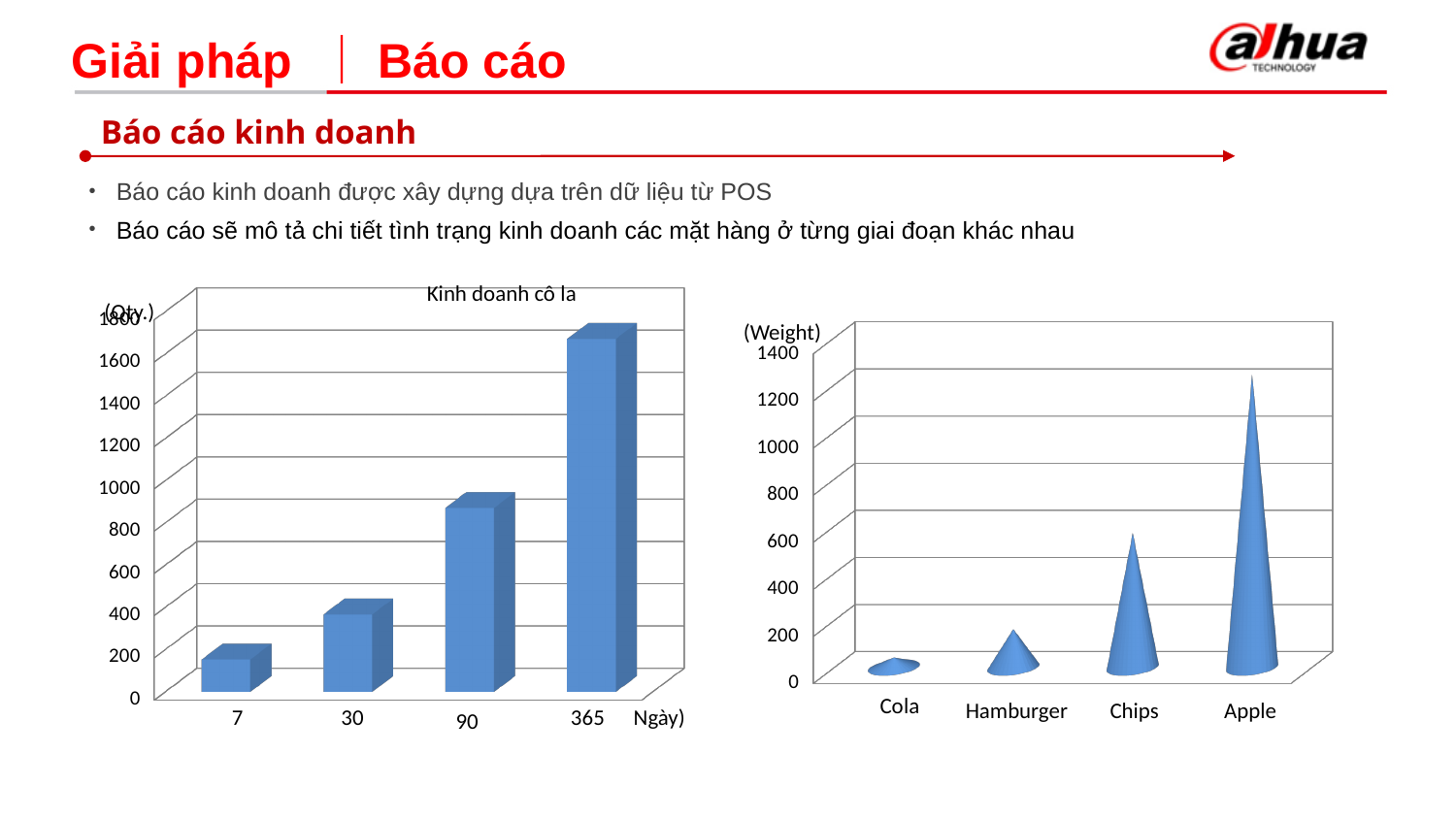
In the left chart "Kinh doanh cô la", is the value for 90 greater or less than 1000? less In the left chart "Kinh doanh cô la", is the value for 365 greater or less than 1400? greater In the right chart, is the value for Chips greater or less than 400? greater What type of chart is the left chart titled "Kinh doanh cô la"? bar chart In the left chart "Kinh doanh cô la", how many categories are shown on the x axis? 4 In the left chart "Kinh doanh cô la", which category has the lowest value? 7 In the right chart, which category has the highest value? Apple In the right chart, how many categories are shown on the x axis? 4 In the right chart, which category has the lowest value? Cola In the left chart "Kinh doanh cô la", do the values rise or fall as the number of days increases along the x axis? rise In the left chart "Kinh doanh cô la", which category has the highest value? 365 In the left chart "Kinh doanh cô la", what is the label shown at the end of the x axis? Ngày)